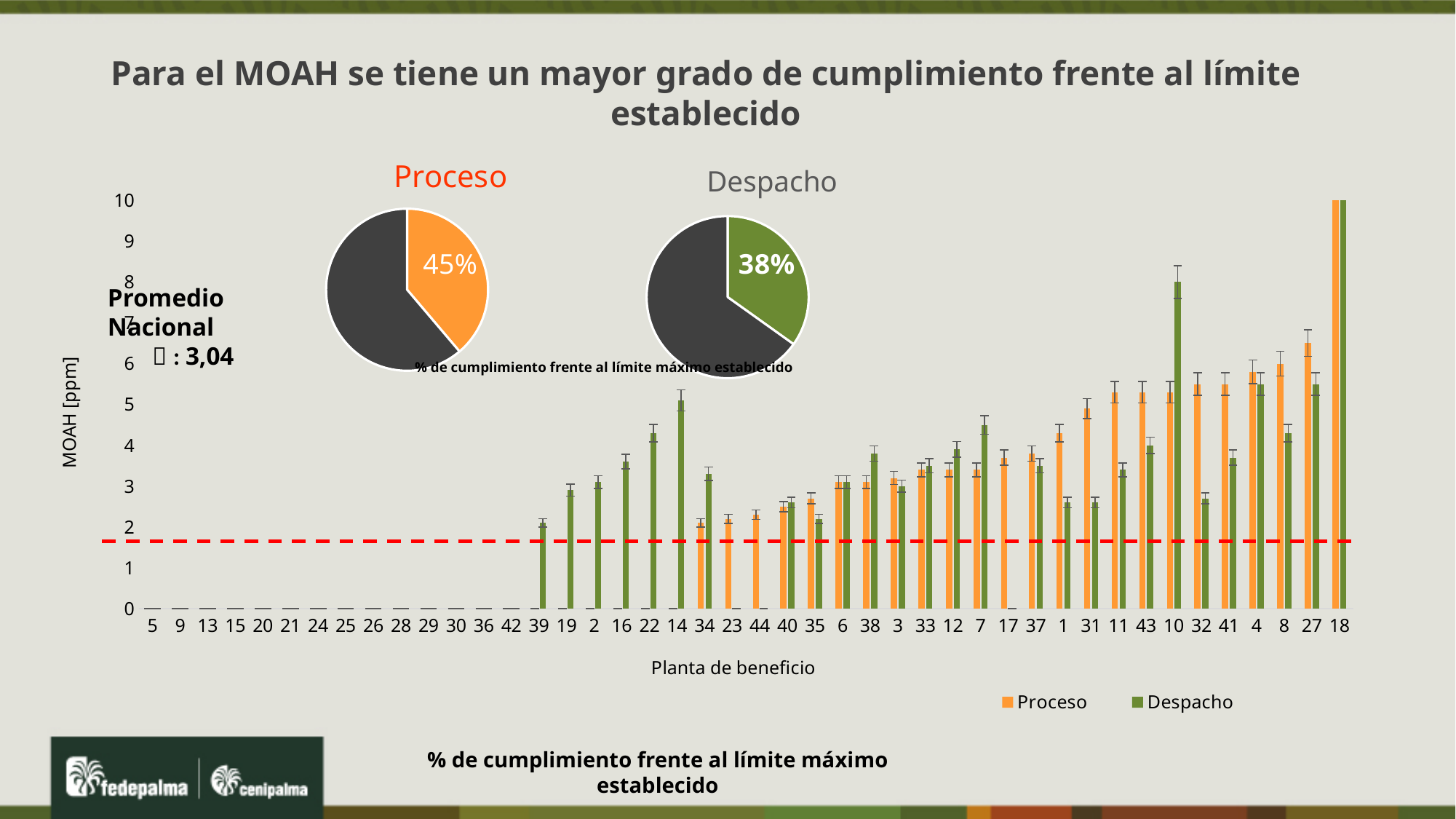
In the bar chart of MOAH [ppm] by Planta de beneficio, do the Proceso values generally rise or fall moving from left to right along the x axis? rise In the bar chart of MOAH [ppm] by Planta de beneficio, how many plants (categories) are shown on the x axis? 44 In the Proceso pie chart, what percentage is shown for the highlighted slice? 45% What kind of chart is the large chart plotting MOAH [ppm] by Planta de beneficio? bar chart In the bar chart of MOAH [ppm] by Planta de beneficio, which plant has the highest Despacho value? 18 In the Despacho pie chart, what percentage is shown for the highlighted slice? 38% Comparing the two pie charts, which has the larger labelled share, Proceso or Despacho? Proceso What is the difference in percentage points between the labelled share in the Proceso pie chart and the labelled share in the Despacho pie chart? 7 In the bar chart of MOAH [ppm] by Planta de beneficio, is the Proceso value for plant 34 greater or less than 3? less In the bar chart of MOAH [ppm] by Planta de beneficio, how many series does the legend list? 2 In the bar chart of MOAH [ppm] by Planta de beneficio, is the Despacho value for plant 10 greater or less than 7? greater In the bar chart of MOAH [ppm] by Planta de beneficio, what colour represents the Despacho series? green